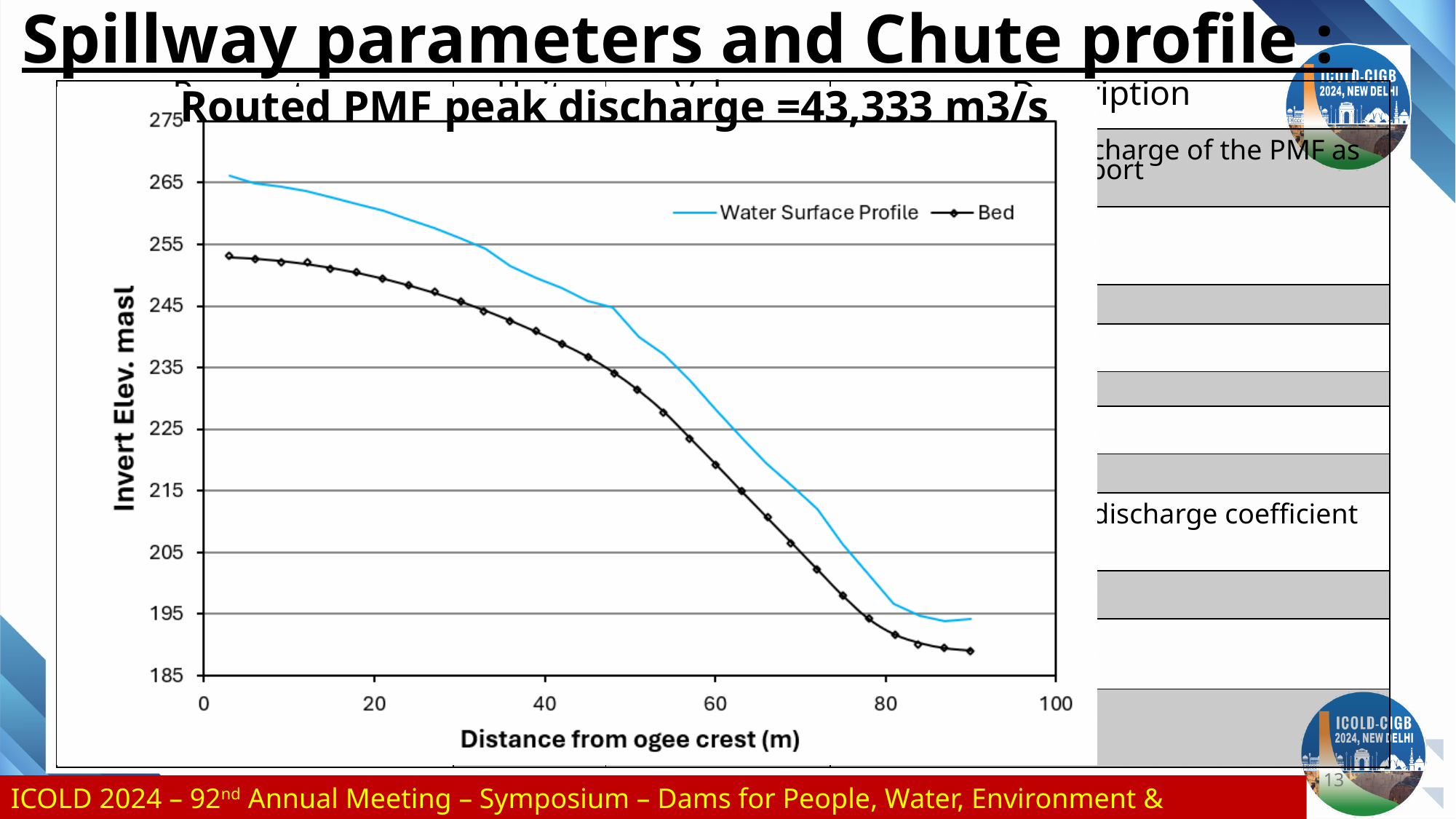
Is the Water Surface Profile elevation at a distance of 20 m greater or less than 255? greater What are the two series named in the chart legend? Water Surface Profile and Bed What is the title of the chart's x axis? Distance from ogee crest (m) What kind of chart is shown on the slide? Line chart Is the Water Surface Profile elevation at a distance of 60 m greater or less than 225? greater How many series does the chart legend list? 2 Is the Bed elevation at a distance of 90 m greater or less than 195? less At a distance of 60 m, which series has the higher elevation, Water Surface Profile or Bed? Water Surface Profile Does the Water Surface Profile rise or fall along the x axis? Fall Do the Bed elevation values rise or fall as the distance from the ogee crest increases? Fall